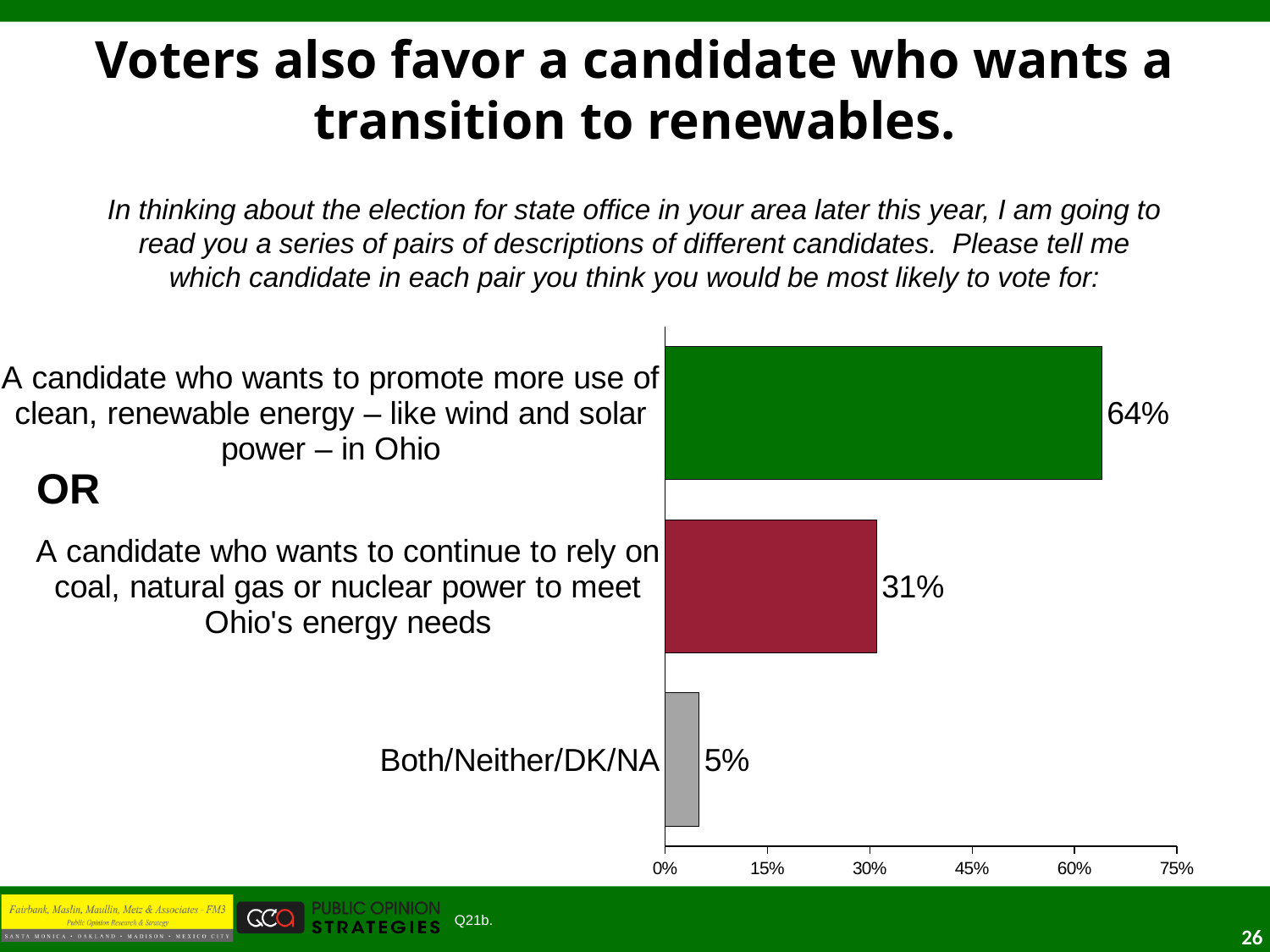
How many bars are shown in the chart? 3 What is the maximum value shown on the percentage axis? 75% Which response category has the lowest value? Both/Neither/DK/NA Which response category has the highest value? A candidate who wants to promote more use of clean, renewable energy – like wind and solar power – in Ohio What is the difference in percentage points between the renewable energy candidate and the coal, natural gas or nuclear candidate? 33 What colour is the bar for the renewable energy candidate? Green What percentage of respondents answered Both/Neither/DK/NA? 5% What kind of chart is shown on the slide? Bar chart What percentage of voters chose the candidate who wants to promote more use of clean, renewable energy in Ohio? 64% Is the value for the renewable energy candidate greater or less than 60%? greater Which is larger: the share for the coal, natural gas or nuclear candidate or the share for Both/Neither/DK/NA? The coal, natural gas or nuclear candidate What percentage of voters chose the candidate who wants to continue to rely on coal, natural gas or nuclear power? 31%